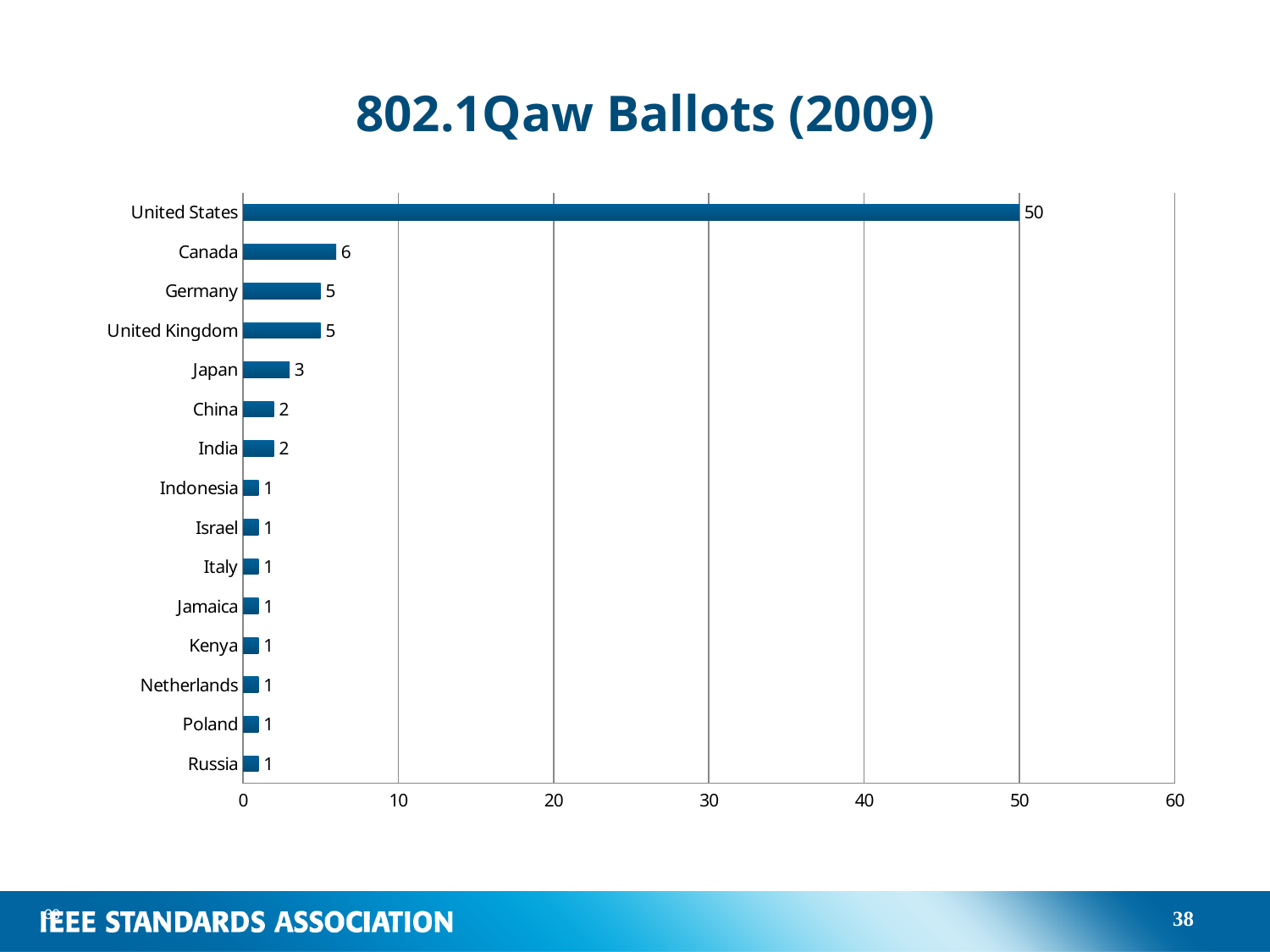
Which is larger, the value for Japan or the value for China? Japan What is the value for Germany? 5 What is the value for Canada? 6 What is the difference between the values for Canada and Japan? 3 What is the value for United States? 50 What kind of chart is shown on the slide? bar chart Is the value for United States greater or less than 40? greater What is the value for Japan? 3 What is the title of the chart? 802.1Qaw Ballots (2009) Which country has the highest value? United States How many countries are shown in the chart? 15 What is the difference between the values for United States and Canada? 44